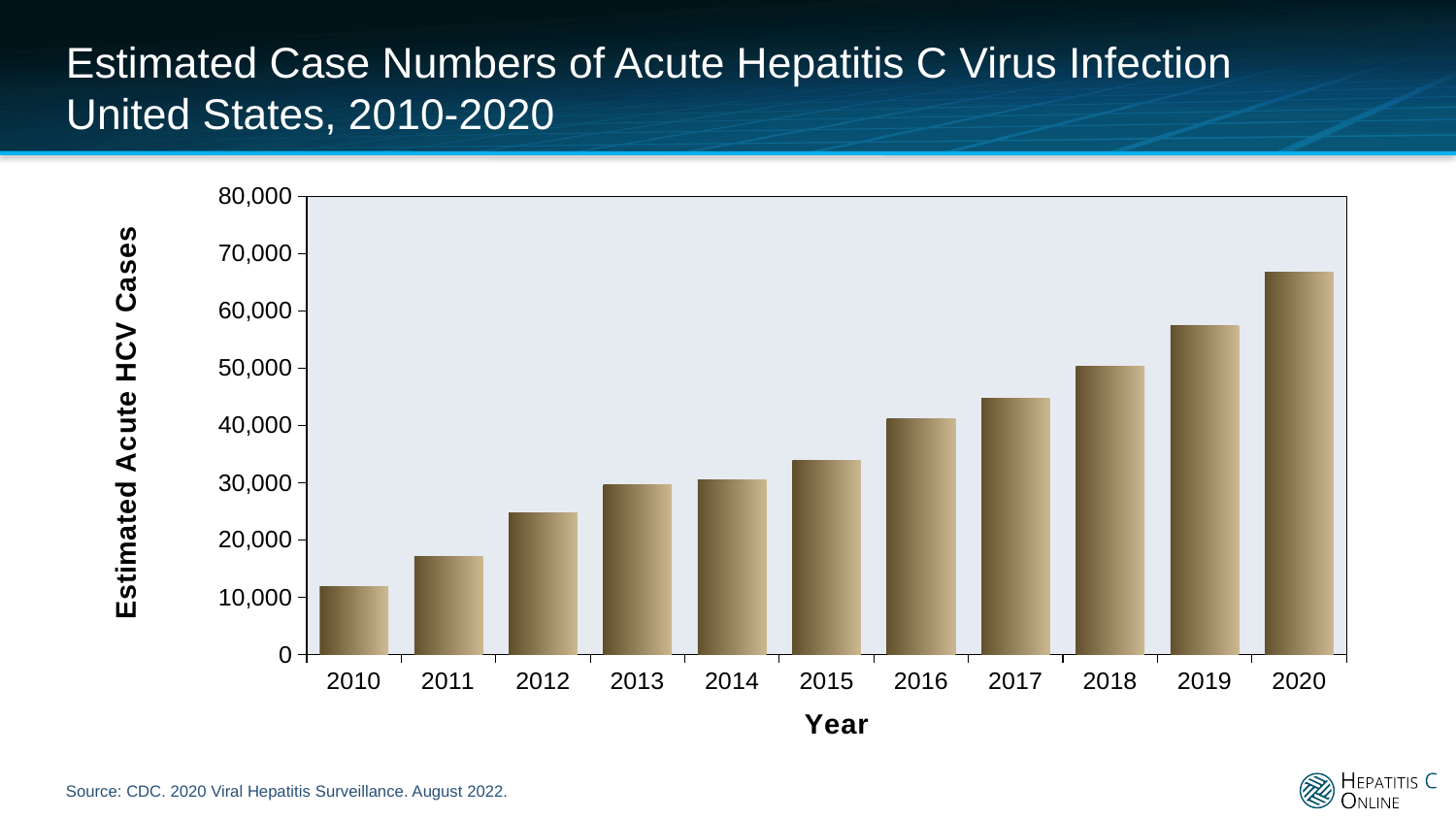
What kind of chart is shown on the slide? bar chart Which year has the lowest estimated number of acute HCV cases? 2010 How many years are plotted on the x axis? 11 Is the value for 2010 greater or less than 20,000? less What is the label of the y axis? Estimated Acute HCV Cases Is the value for 2020 greater or less than 60,000? greater Which year has the highest estimated number of acute HCV cases? 2020 Do the estimated acute HCV cases rise or fall from 2010 to 2020? rise Which year has more estimated acute HCV cases, 2017 or 2019? 2019 Is the value for 2017 greater or less than 50,000? less